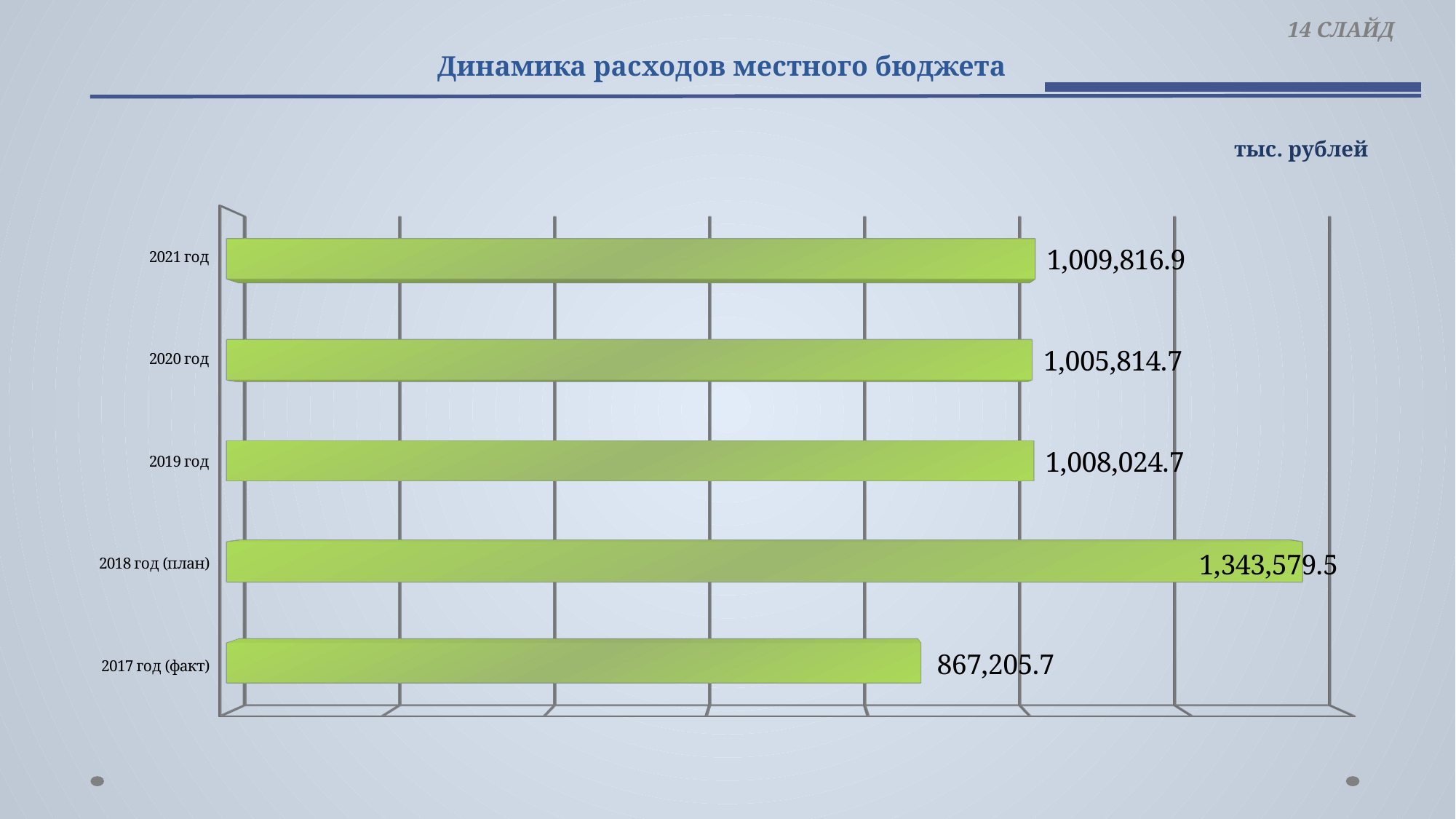
Which category has the lowest value? 2017 год (факт) What is the title of the chart? Динамика расходов местного бюджета Which is larger, the value for 2021 год or the value for 2020 год? 2021 год What is the difference between the values for 2018 год (план) and 2017 год (факт)? 476,373.8 What is the value for 2017 год (факт)? 867,205.7 What is the difference between the values for 2021 год and 2020 год? 4,002.2 What is the value for 2018 год (план)? 1,343,579.5 What is the value for 2019 год? 1,008,024.7 How many categories are shown in the chart? 5 Which category has the highest value? 2018 год (план) What kind of chart is shown on the slide? Bar chart What is the value for 2021 год? 1,009,816.9